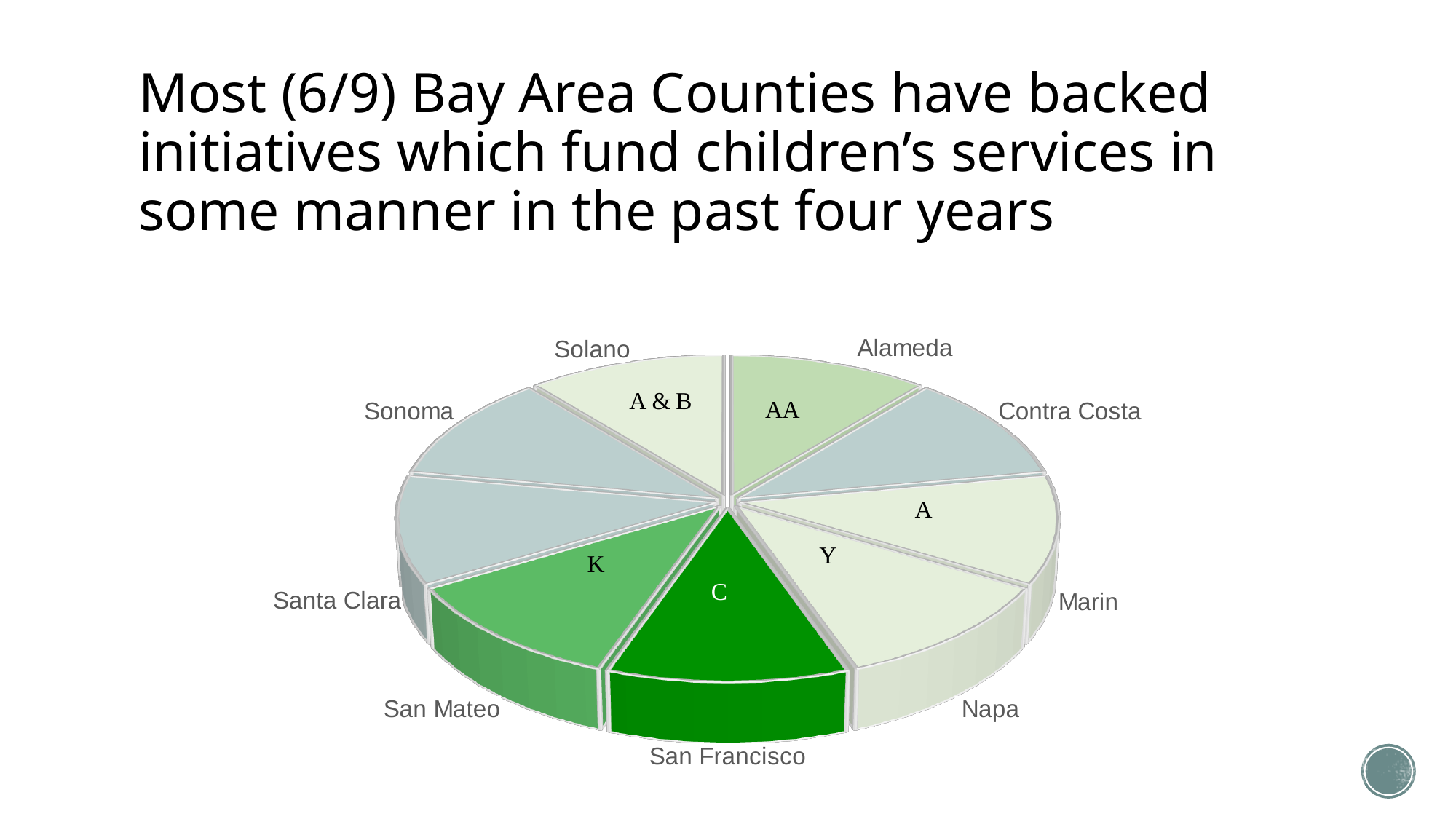
How many slices in the pie chart carry a letter label? 6 Which three counties in the pie chart have no letter label on their slice? Contra Costa, Santa Clara, Sonoma What label is printed on the Napa slice of the pie chart? Y What label is printed on the Solano slice of the pie chart? A & B What label is printed on the Marin slice of the pie chart? A Which county's slice is labeled "C" in the pie chart? San Francisco What label is printed on the Alameda slice of the pie chart? AA Which county's slice is labeled "K" in the pie chart? San Mateo What kind of chart is shown on the slide? pie chart How many counties (slices) are shown in the pie chart? 9 Which slice of the pie chart is shown in the darkest green? San Francisco